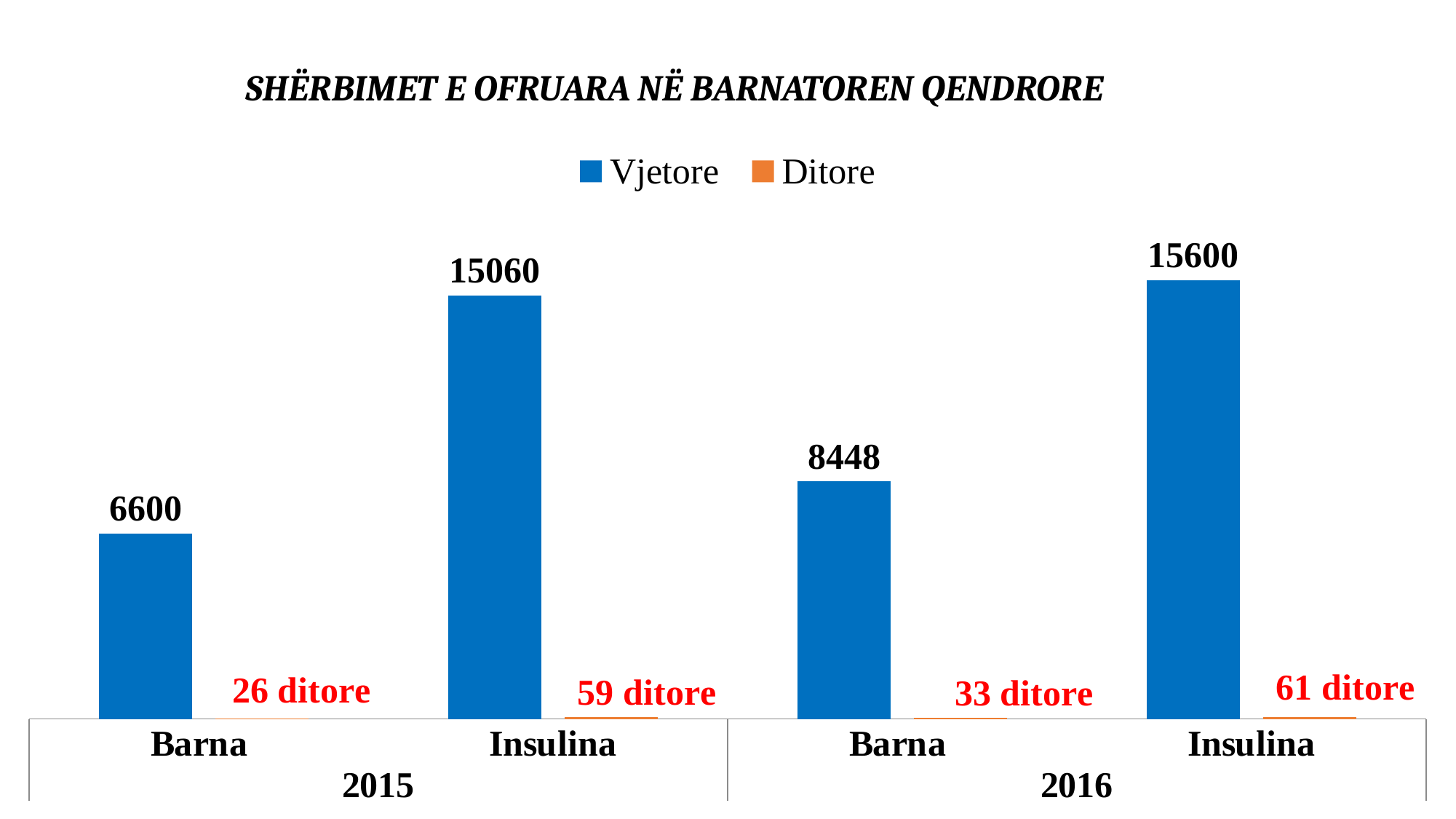
Which is larger, the Vjetore value for Insulina in 2015 or for Barna in 2016? Insulina in 2015 What is the difference between the Vjetore values for Insulina in 2016 and Insulina in 2015? 540 Which category has the lowest Vjetore value? Barna 2015 What is the Vjetore value for Insulina in 2016? 15600 What is the difference between the Vjetore values for Barna in 2016 and Barna in 2015? 1848 What is the Vjetore value for Barna in 2015? 6600 Which category has the highest Vjetore value? Insulina 2016 What is the Ditore value for Barna in 2016? 33 ditore How many series does the legend list? 2 What is the title of the chart? SHËRBIMET E OFRUARA NË BARNATOREN QENDRORE What is the Ditore value for Insulina in 2015? 59 ditore What kind of chart is shown on the slide? Bar chart